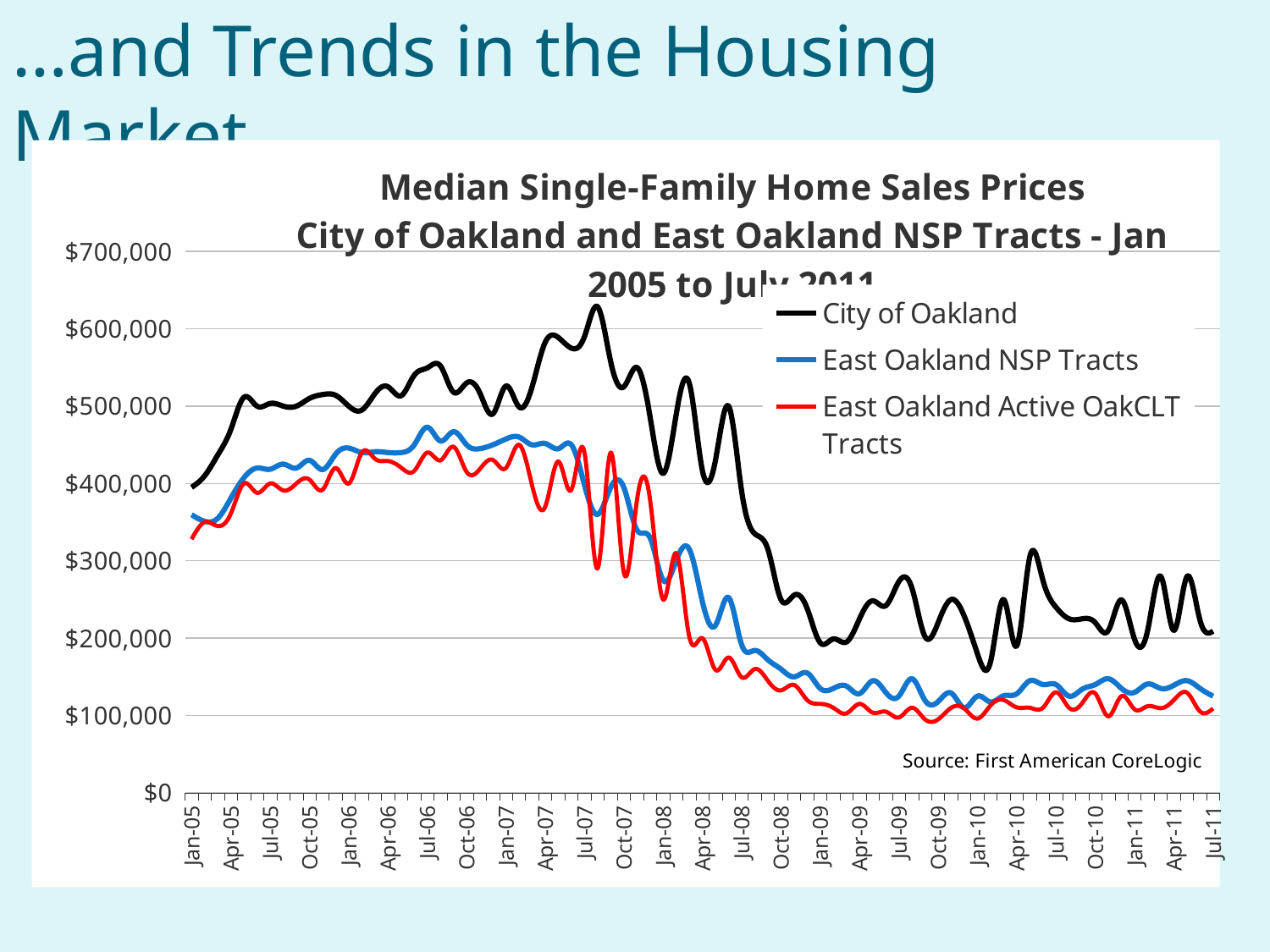
At Jul-09, which is higher: City of Oakland or East Oakland Active OakCLT Tracts? City of Oakland At Jan-05, which is higher: City of Oakland or East Oakland NSP Tracts? City of Oakland Overall, do the City of Oakland median sales prices rise or fall between Jan-08 and Jul-11? fall What are the three series listed in the legend? City of Oakland, East Oakland NSP Tracts, East Oakland Active OakCLT Tracts Which series has the highest value at Jul-11? City of Oakland How many series does the legend list? 3 Which series has the lowest value at Oct-09? East Oakland Active OakCLT Tracts What source is cited for the chart data? First American CoreLogic Is the City of Oakland value at its Jul-07 peak greater or less than $600,000? greater Is the East Oakland NSP Tracts value at Jan-06 greater or less than $400,000? greater Is the East Oakland Active OakCLT Tracts value at Jul-11 greater or less than $200,000? less What kind of chart is shown on the slide? line chart